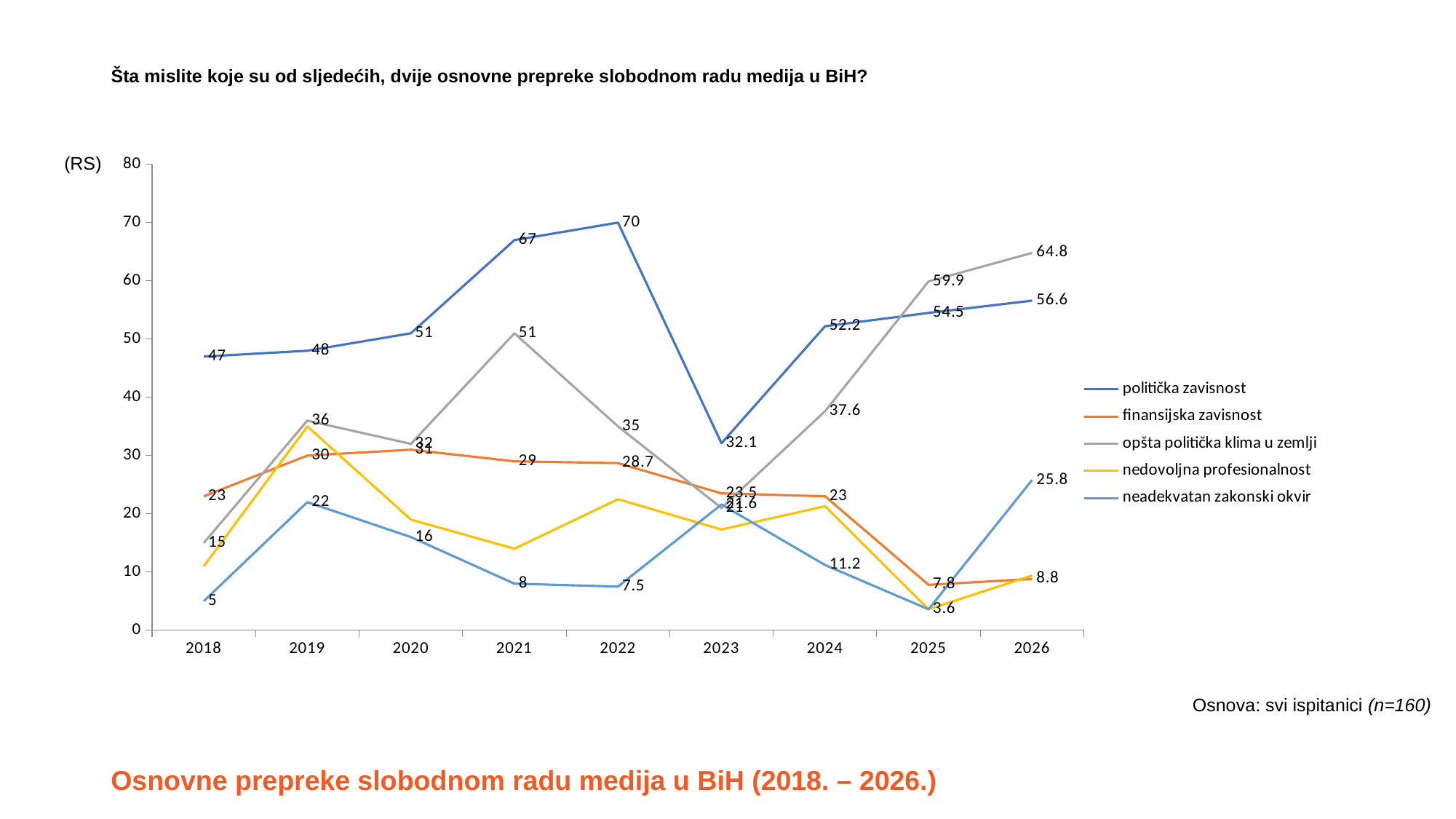
What is the value for neadekvatan zakonski okvir in 2018? 5 In which year does politička zavisnost reach its highest value? 2022 In 2021, which is larger: politička zavisnost or opšta politička klima u zemlji? politička zavisnost What is the difference between the politička zavisnost values in 2022 and 2023? 37.9 What is the value for politička zavisnost in 2022? 70 How many series does the legend list? 5 Which series has the lowest value in 2018? neadekvatan zakonski okvir Is the value for nedovoljna profesionalnost in 2019 greater or less than 30? greater What is the value for opšta politička klima u zemlji in 2026? 64.8 What kind of chart is shown on the slide? line chart How many years are shown on the x axis? 9 What is the value for finansijska zavisnost in 2019? 30